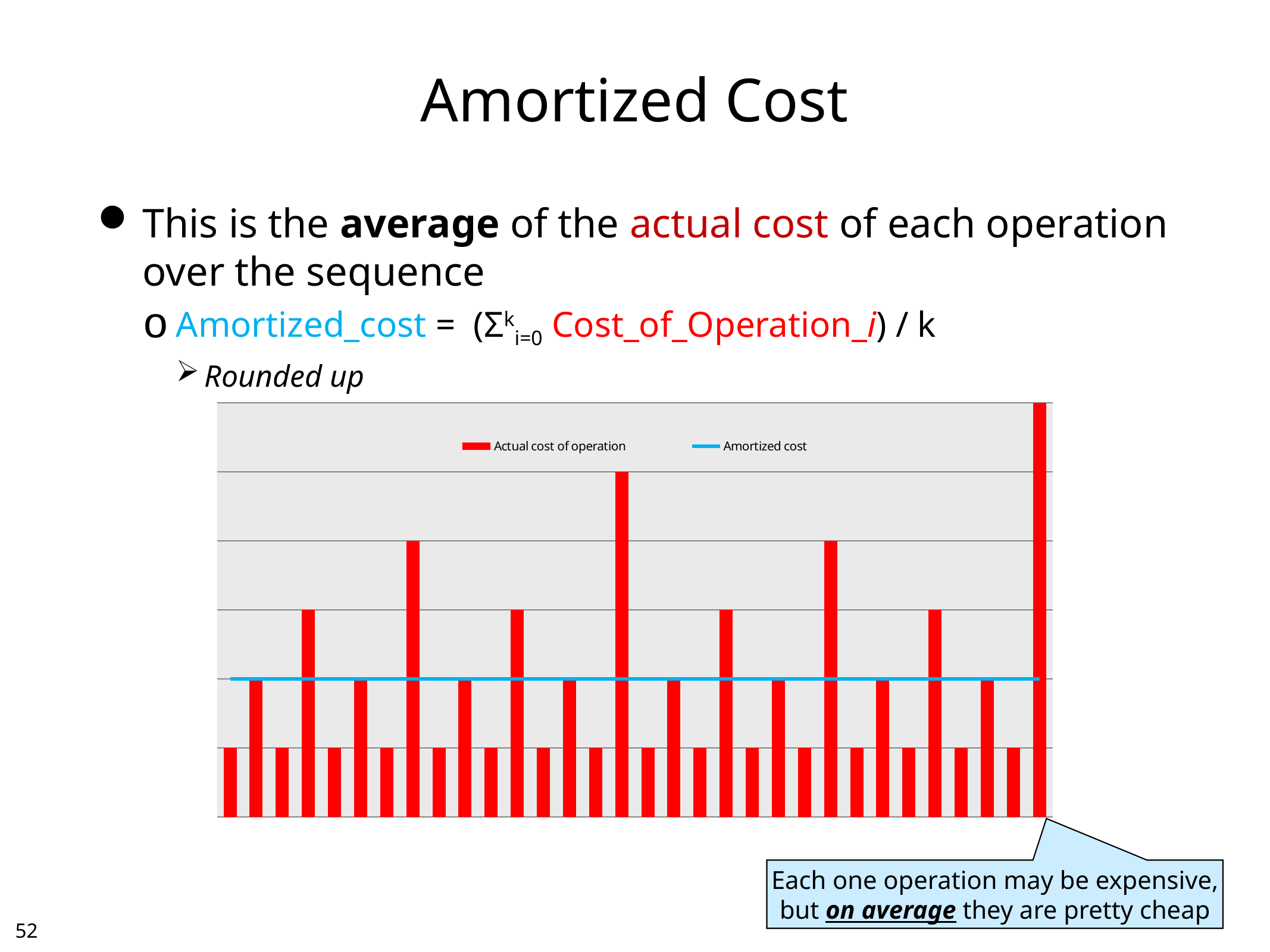
What kind of chart is shown on the slide? Bar chart with a line How many series does the legend list? 2 What colour are the bars for Actual cost of operation? Red Which series is drawn as a blue line? Amortized cost Which is larger: the actual cost of the rightmost bar or the actual cost of the bar in the middle of the chart (the 16th bar)? The rightmost bar Which bar has the highest actual cost of operation? The rightmost (last) bar Does the Amortized cost line rise, fall, or stay flat across the chart? Stays flat Do the actual costs of operation rise steadily from left to right? No Which is larger: the actual cost of the 16th bar or the actual cost of the 8th bar? The 16th bar How many bars are plotted in the chart? 32